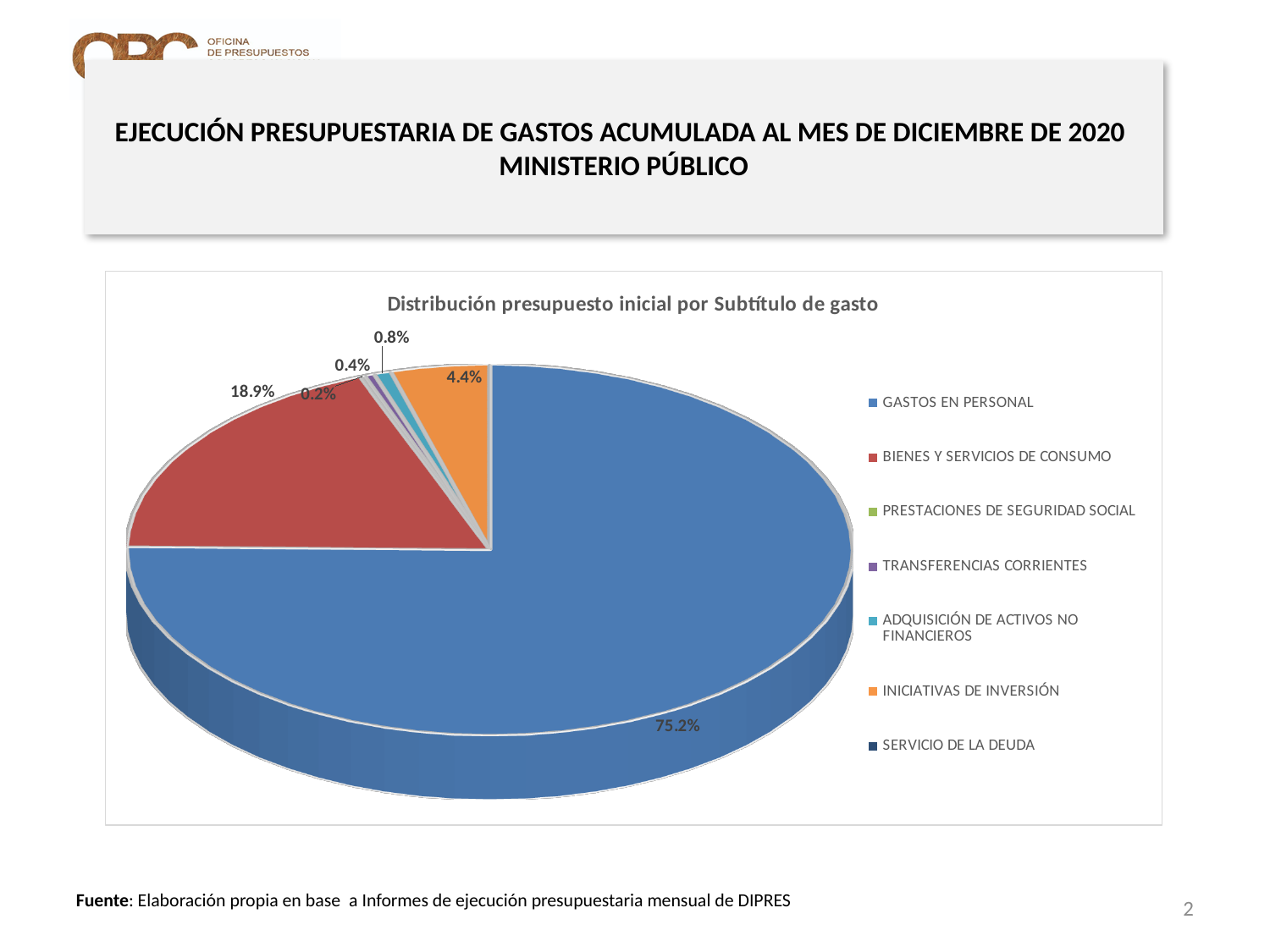
What is the value shown for BIENES Y SERVICIOS DE CONSUMO? 18.9% What is the value shown for INICIATIVAS DE INVERSIÓN? 4.4% Which is larger, the share for BIENES Y SERVICIOS DE CONSUMO or the share for INICIATIVAS DE INVERSIÓN? BIENES Y SERVICIOS DE CONSUMO What is the value shown for ADQUISICIÓN DE ACTIVOS NO FINANCIEROS? 0.8% What share of the pie does GASTOS EN PERSONAL represent? 75.2% What is the value shown for TRANSFERENCIAS CORRIENTES? 0.4% What kind of chart is shown on the slide? pie chart How many categories does the legend list? 7 What colour is the slice for GASTOS EN PERSONAL? blue What is the difference between the shares of GASTOS EN PERSONAL and BIENES Y SERVICIOS DE CONSUMO? 56.3% Which category has the largest share of the pie? GASTOS EN PERSONAL What is the title of the chart? Distribución presupuesto inicial por Subtítulo de gasto